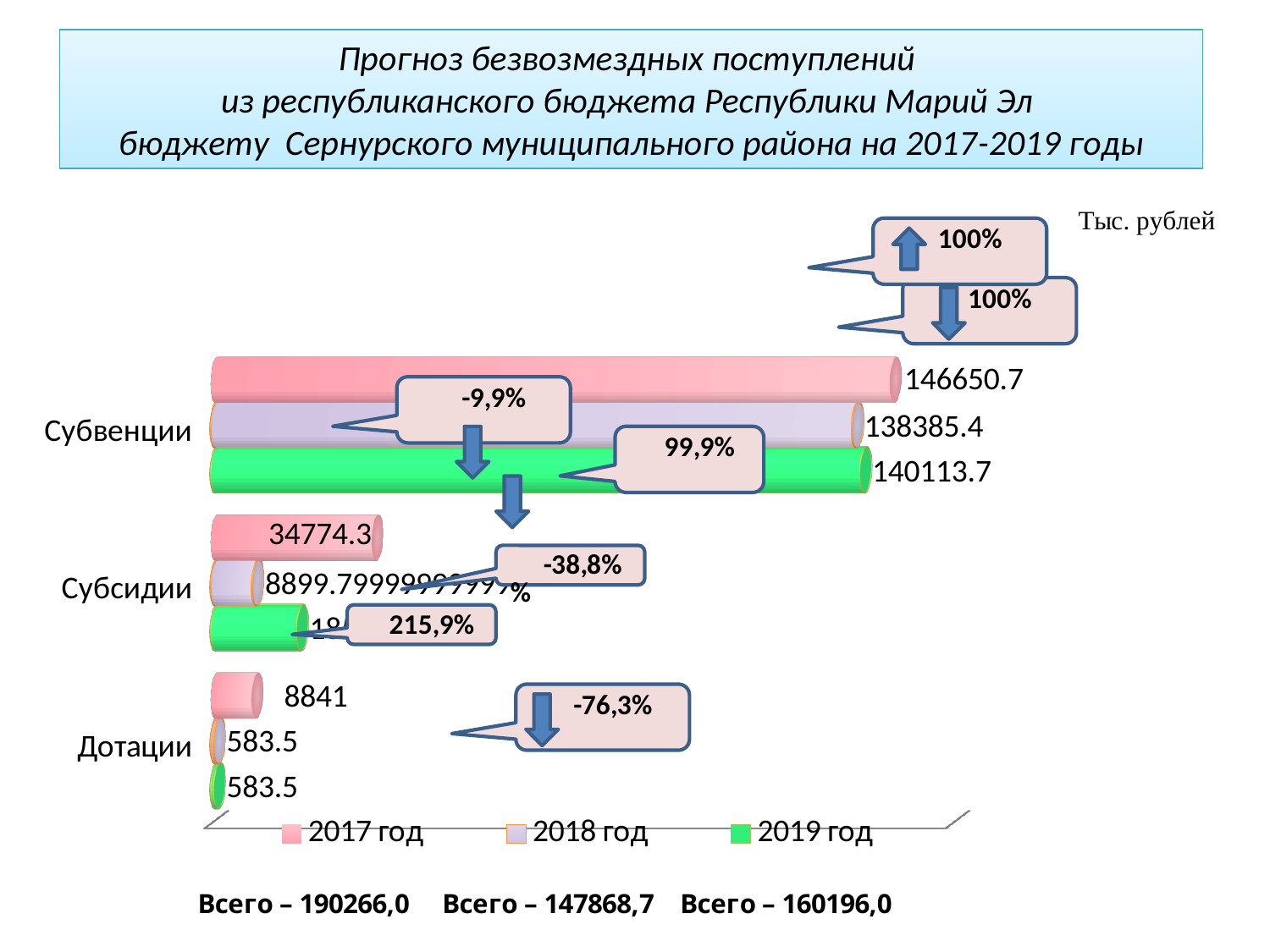
What is the value for Субвенции in 2019 год? 140113.7 What is the value for Субвенции in 2018 год? 138385.4 What is the value for Дотации in 2018 год? 583.5 What kind of chart is shown on the slide? bar chart Which category has the lowest value in 2019 год? Дотации What is the value for Субсидии in 2017 год? 34774.3 How many series does the legend list? 3 What is the value for Дотации in 2017 год? 8841 What is the difference between the 2017 год and 2018 год values for Субвенции? 8265.3 Which category has the highest value in 2017 год? Субвенции How many categories are shown on the chart? 3 What is the value for Субвенции in 2017 год? 146650.7